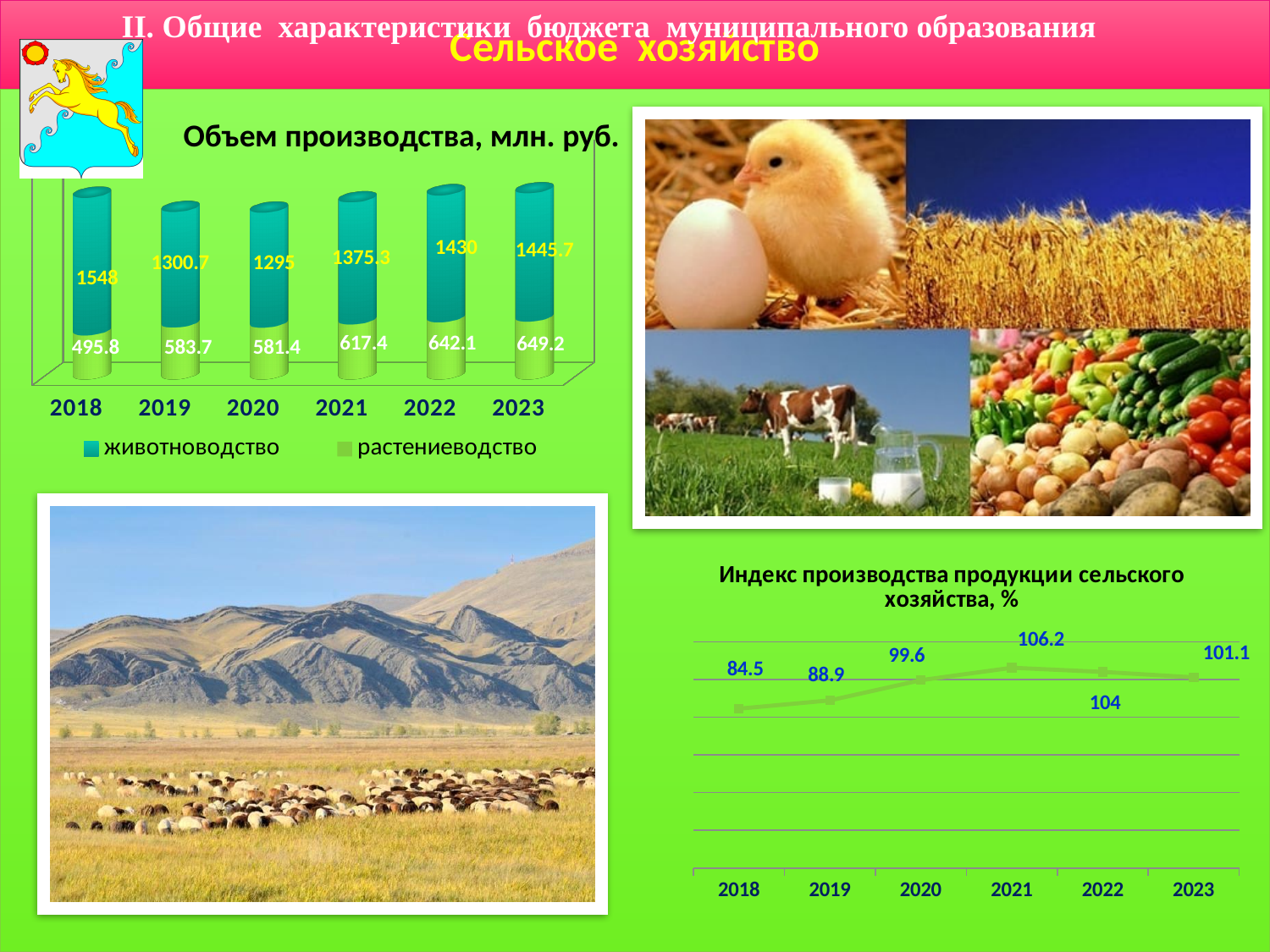
In the chart 'Объем производства, млн. руб.', what is the value for растениеводство in 2023? 649.2 In the chart 'Объем производства, млн. руб.', what is the total of the stacked bar for 2023? 2094.9 What type of chart is 'Объем производства, млн. руб.'? Bar chart In the chart 'Объем производства, млн. руб.', which year has the highest value for животноводство? 2018 In the chart 'Индекс производства продукции сельского хозяйства, %', which year has the lowest value? 2018 In the chart 'Объем производства, млн. руб.', which year has the lowest value for растениеводство? 2018 In the chart 'Индекс производства продукции сельского хозяйства, %', is the value for 2022 or 2023 larger? 2022 In the chart 'Объем производства, млн. руб.', what is the value for животноводство in 2018? 1548 In the chart 'Индекс производства продукции сельского хозяйства, %', what is the value for 2021? 106.2 How many series does the legend of the chart 'Объем производства, млн. руб.' list? 2 How many years are plotted in the chart 'Индекс производства продукции сельского хозяйства, %'? 6 In the chart 'Объем производства, млн. руб.', what is the difference between the растениеводство values for 2023 and 2018? 153.4